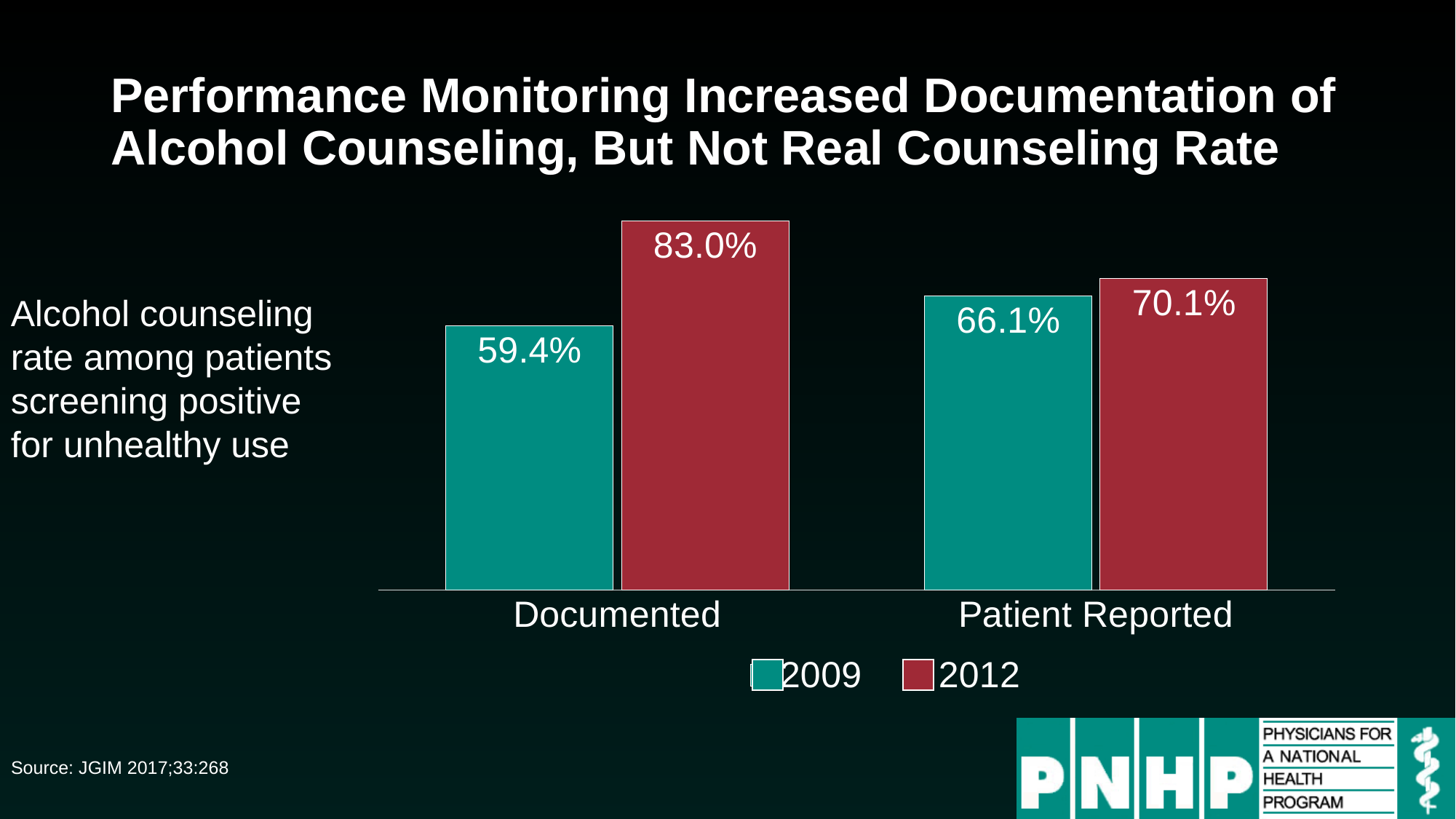
What was the documented alcohol counseling rate in 2012? 83.0% By how many percentage points did the documented counseling rate increase from 2009 to 2012? 23.6 Which was larger in 2009: the documented rate or the patient reported rate? Patient Reported What was the patient reported alcohol counseling rate in 2009? 66.1% What was the documented alcohol counseling rate in 2009? 59.4% Which colour represents 2012 in the chart? Red Which bar shows the lowest value on the chart? Documented, 2009 Which bar shows the highest value on the chart? Documented, 2012 What was the patient reported alcohol counseling rate in 2012? 70.1% How many series does the legend list? 2 By how many percentage points did the patient reported counseling rate increase from 2009 to 2012? 4.0 What kind of chart is shown on the slide? Bar chart